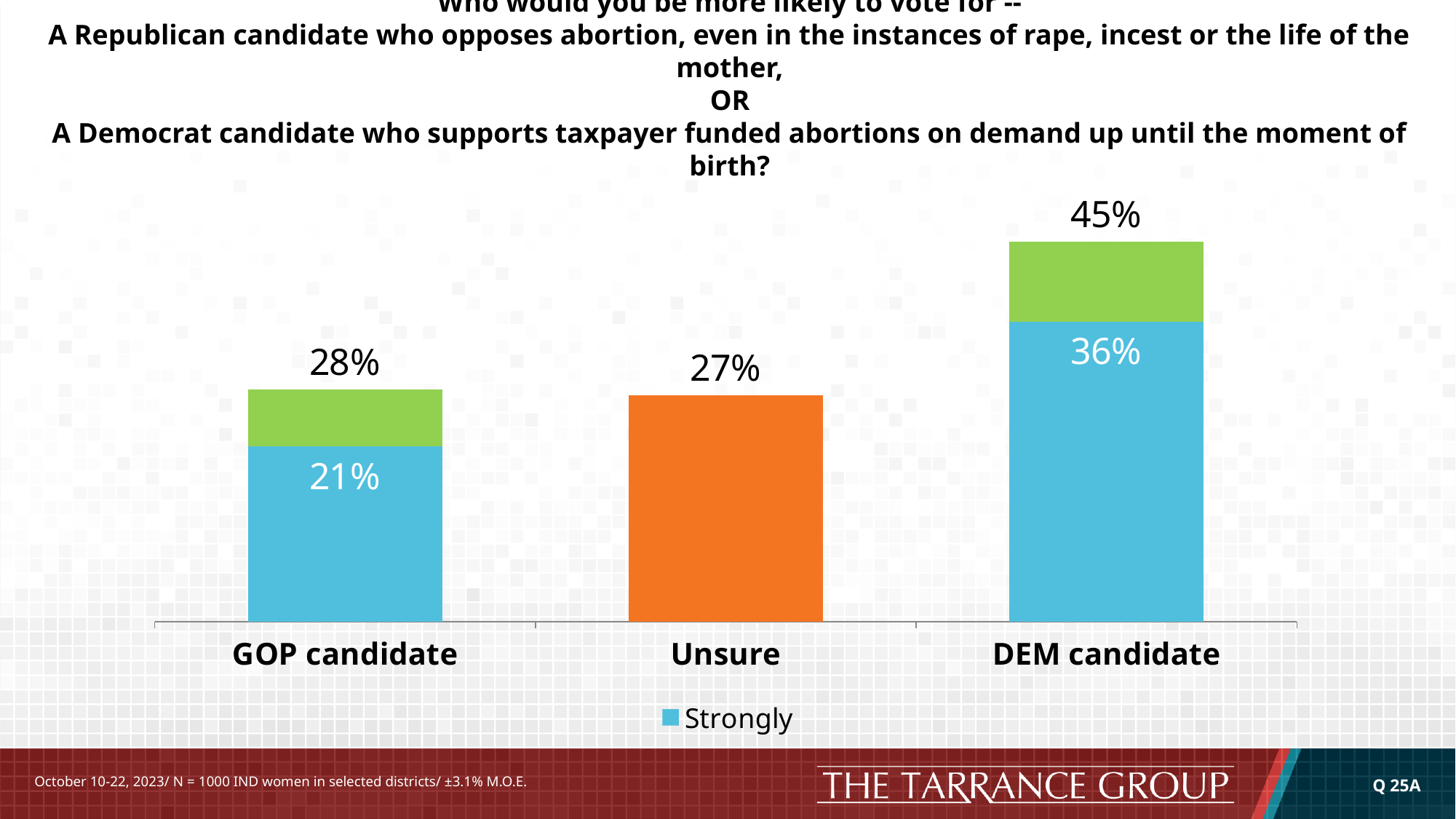
What kind of chart is shown on the slide? Bar chart What is the 'Strongly' value for DEM candidate? 36% What is the difference between the total for DEM candidate and the total for GOP candidate? 17% What series name does the legend list? Strongly How many categories are shown on the x axis? 3 What is the total value shown for DEM candidate? 45% What is the 'Strongly' value for GOP candidate? 21% Which category has the highest total value? DEM candidate What is the value shown for Unsure? 27% What is the total value shown for GOP candidate? 28% What is the difference between the 'Strongly' values for DEM candidate and GOP candidate? 15% Which is larger, the total for GOP candidate or the value for Unsure? GOP candidate